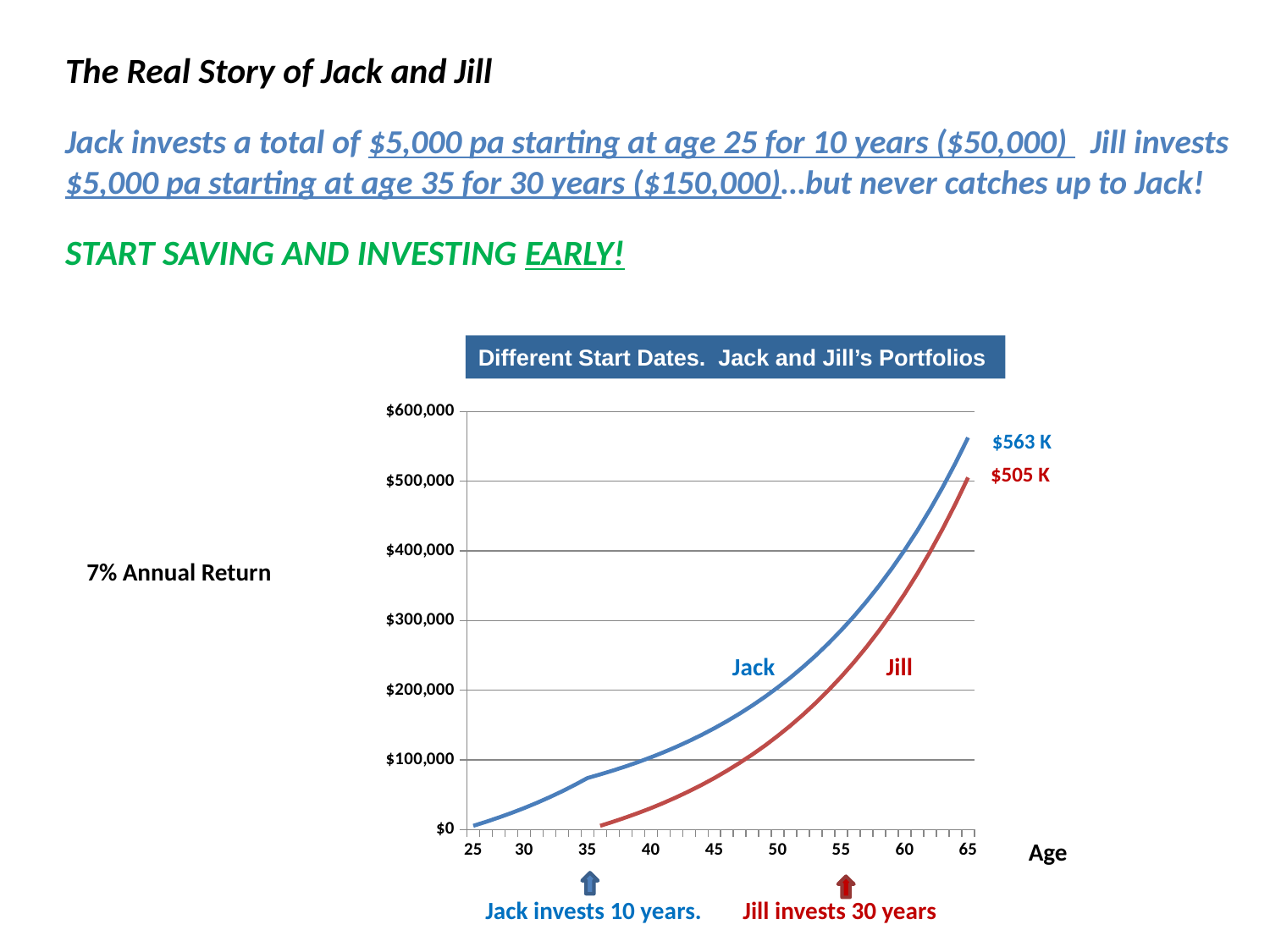
What is the value of Jack's portfolio at age 65? $563 K What is the difference between Jack's and Jill's portfolio values at age 65? $58 K What is the title of the chart? Different Start Dates. Jack and Jill's Portfolios What annual return is stated next to the chart? 7% Annual Return What type of chart is shown on the slide? line chart Is the value of Jill's portfolio at age 45 greater or less than $100,000? less Do the portfolio values rise or fall as age increases along the x axis? rise Which series reaches the highest value on the chart? Jack How many series (lines) are plotted on the chart? 2 Is the value of Jack's portfolio at age 45 greater or less than $200,000? less What is the value of Jill's portfolio at age 65? $505 K Whose portfolio is larger at age 65, Jack's or Jill's? Jack